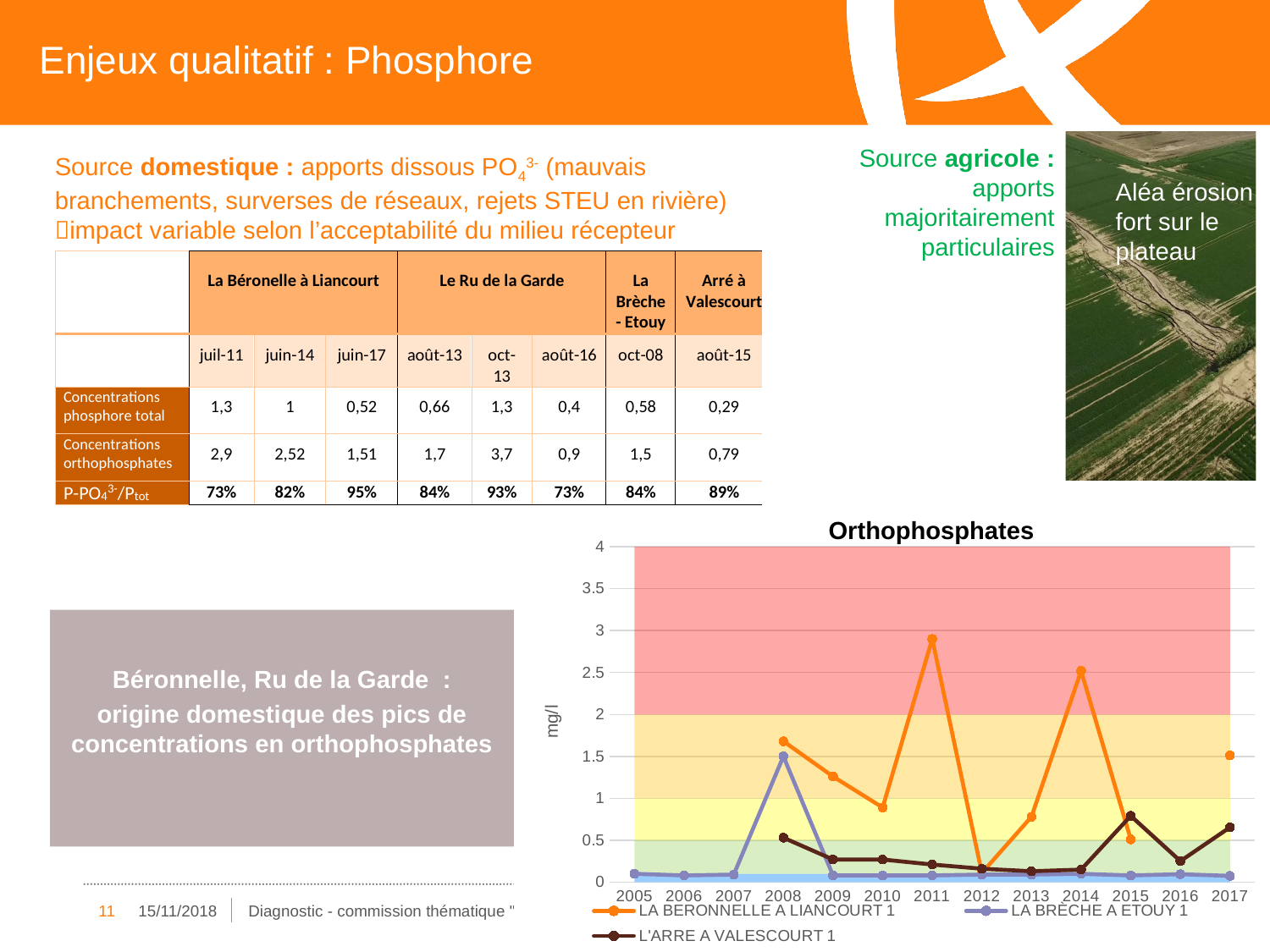
In 2011, which series has the larger value: LA BERONNELLE A LIANCOURT 1 or L'ARRE A VALESCOURT 1? LA BERONNELLE A LIANCOURT 1 How many series does the legend of the Orthophosphates chart list? 3 Is the 2014 value for LA BERONNELLE A LIANCOURT 1 greater or less than 2? greater Is the 2008 value for LA BRECHE A ETOUY 1 greater or less than 1? greater Is the 2011 value for LA BERONNELLE A LIANCOURT 1 greater or less than 2.5? greater Does the value for LA BERONNELLE A LIANCOURT 1 rise or fall from 2011 to 2012? fall What unit is shown on the y axis of the Orthophosphates chart? mg/l How many years are shown on the x axis of the Orthophosphates chart? 13 What kind of chart is the Orthophosphates chart? line chart In which year does LA BERONNELLE A LIANCOURT 1 reach its highest value on the Orthophosphates chart? 2011 Which series reaches the highest value on the Orthophosphates chart? LA BERONNELLE A LIANCOURT 1